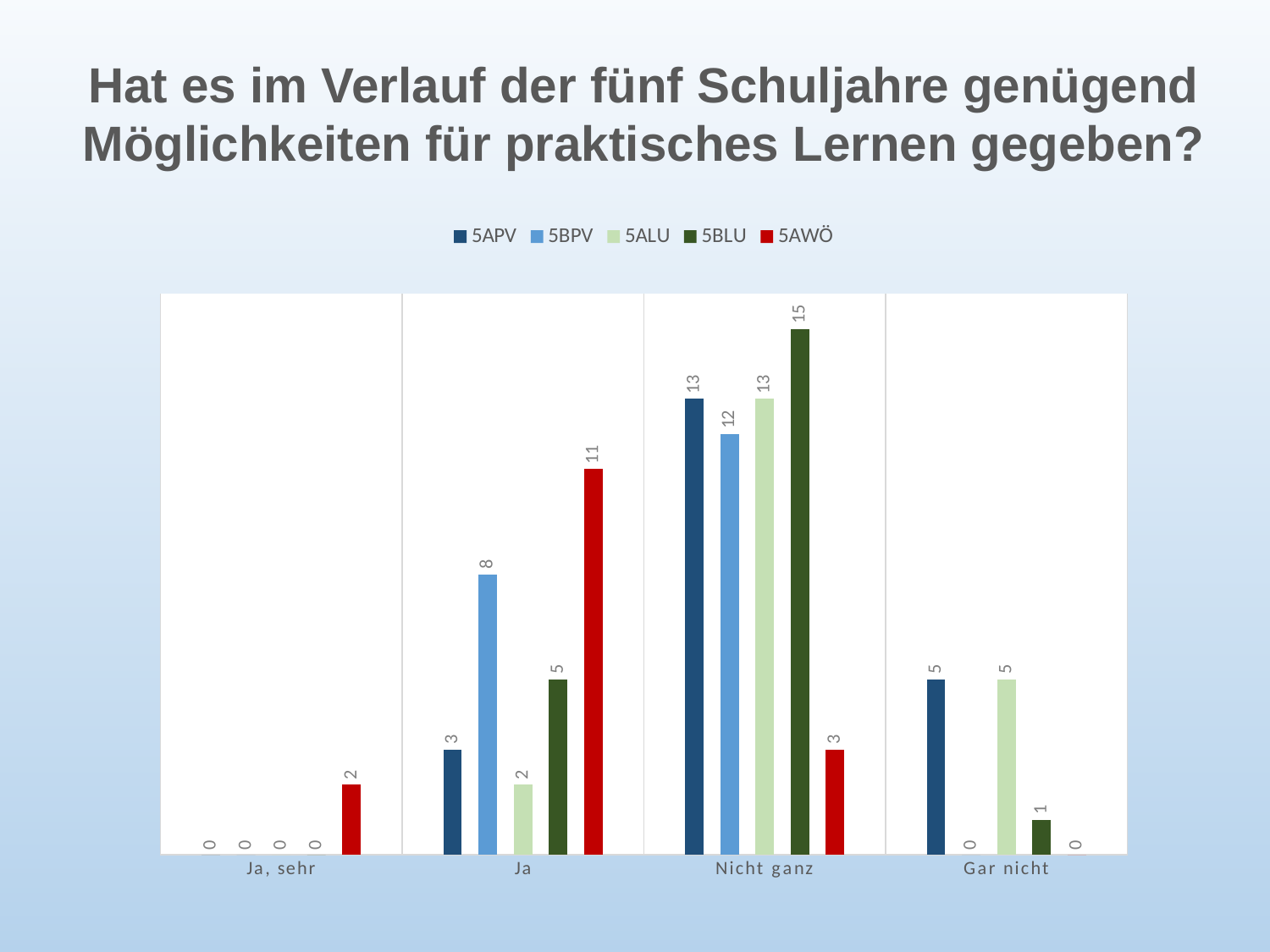
What kind of chart is shown on the slide? Bar chart What is the difference between the 5BLU and 5AWÖ values in the "Nicht ganz" category? 12 What is the value for 5BPV in the "Ja" category? 8 How many categories are shown on the x axis? 4 What is the value for 5AWÖ in the "Ja" category? 11 What is the value for 5BLU in the "Gar nicht" category? 1 Which series has the highest value in the "Nicht ganz" category? 5BLU Which is larger: the 5BPV value for "Ja" or the 5BLU value for "Ja"? 5BPV Which series has the lowest value in the "Ja" category? 5ALU What is the value for 5BLU in the "Nicht ganz" category? 15 Which series is shown in red in the legend? 5AWÖ How many series does the legend list? 5